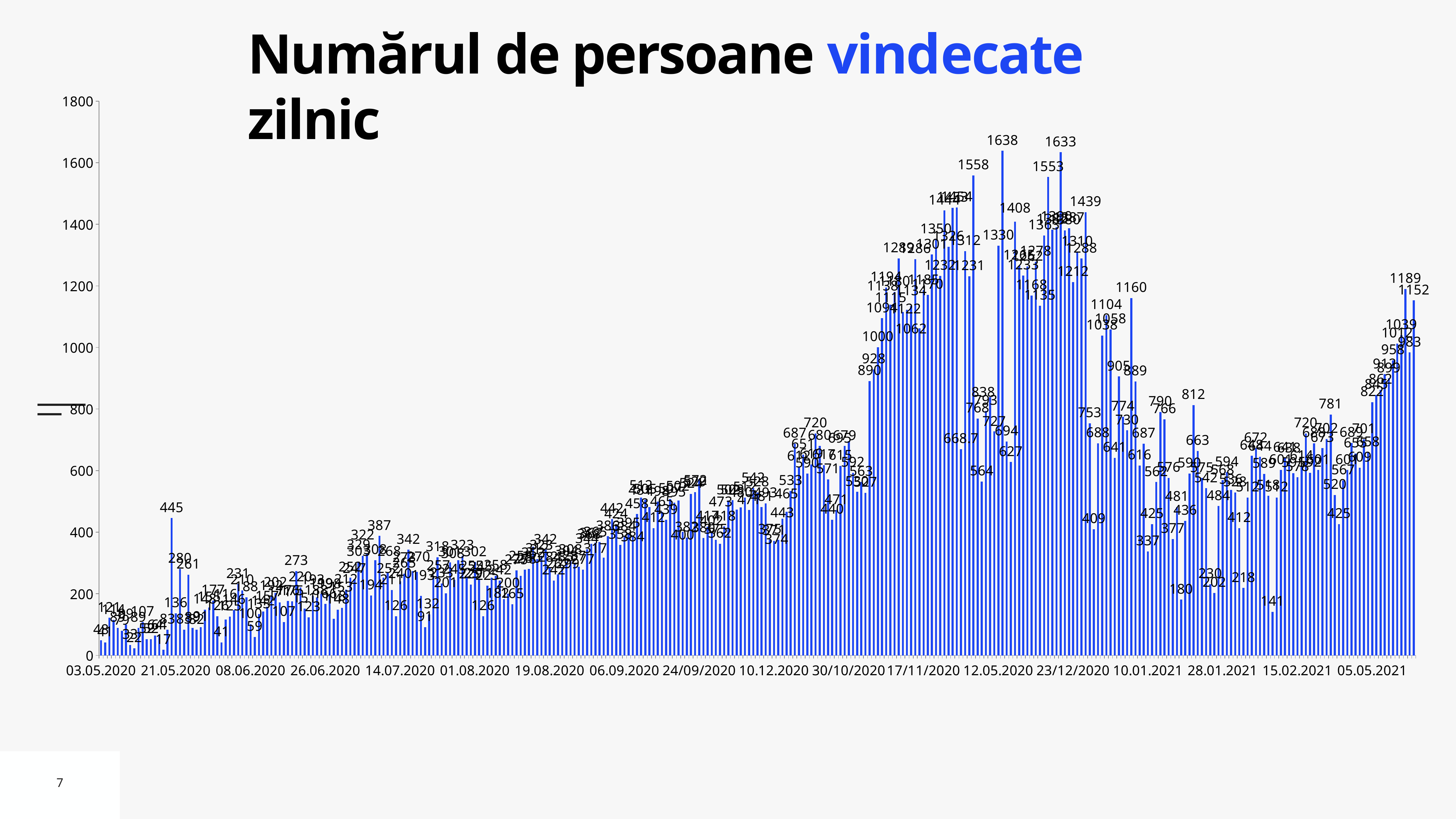
What is the second-highest labelled value in the chart? 1633 What is the highest daily value shown in the chart? 1638 What is the title of the chart? Numărul de persoane vindecate zilnic Is the value of the tallest bar greater or less than 1600? greater What is the value of the last bar on the right of the chart? 1152 Which is larger, the peak value 1638 or the value 1558 shown just before it? 1638 What is the highest value on the vertical axis? 1800 What is the first date label on the horizontal axis? 03.05.2020 What is the difference between the two highest labelled values, 1638 and 1633? 5 What kind of chart is shown on the slide? bar chart Overall, do the values rise or fall from the left of the chart to the peak around 17/11/2020? rise